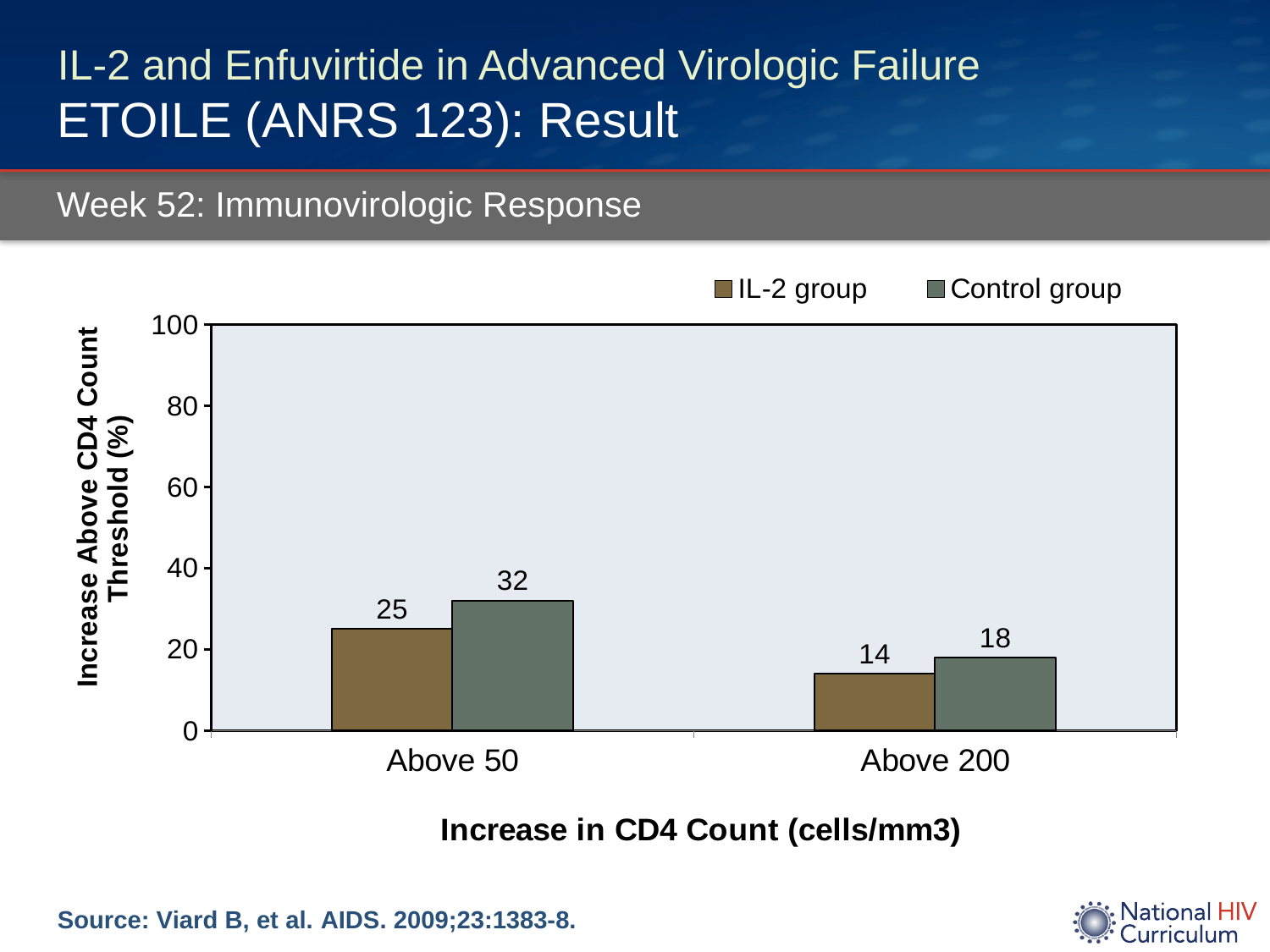
What is the difference between the Control group and the IL-2 group in the Above 50 category? 7 What is the value for the IL-2 group in the Above 50 category? 25 In the Above 200 category, which group has the larger value, IL-2 group or Control group? Control group Which bar has the highest value on the chart? Control group, Above 50 What is the value for the Control group in the Above 200 category? 18 What kind of chart is shown on the slide? Bar chart How many series does the legend list? 2 What is the difference between the Control group and the IL-2 group in the Above 200 category? 4 Which bar has the lowest value on the chart? IL-2 group, Above 200 What is the value for the IL-2 group in the Above 200 category? 14 What is the value for the Control group in the Above 50 category? 32 How many categories are shown on the x axis? 2